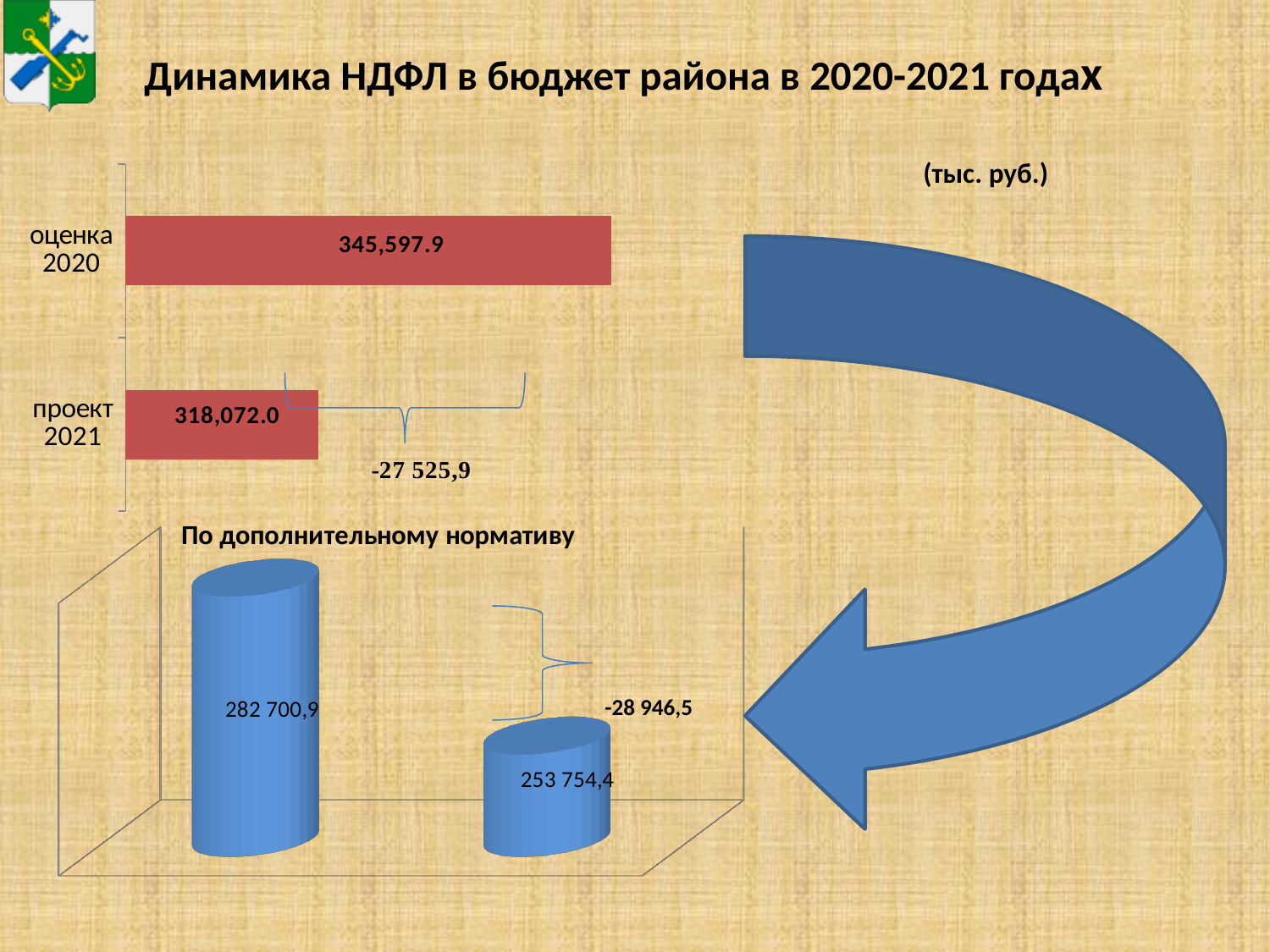
On the chart titled 'По дополнительному нормативу', what is the value of the left cylinder? 282 700,9 What unit is indicated for the values on the slide? тыс. руб. On the chart titled 'По дополнительному нормативу', which cylinder is taller, the left or the right? left How many bars are shown on the top bar chart? 2 On the chart titled 'По дополнительному нормативу', what is the value of the right cylinder? 253 754,4 What is the title of the slide? Динамика НДФЛ в бюджет района в 2020-2021 годах What kind of chart is the top chart on the slide? bar chart On the top bar chart, what is the value for проект 2021? 318,072.0 On the chart titled 'По дополнительному нормативу', what is the difference between the two values, as printed on the slide? -28 946,5 On the top bar chart, what is the value for оценка 2020? 345,597.9 On the top bar chart, what is the difference between проект 2021 and оценка 2020, as printed on the slide? -27 525,9 On the top bar chart, which category has the higher value, оценка 2020 or проект 2021? оценка 2020